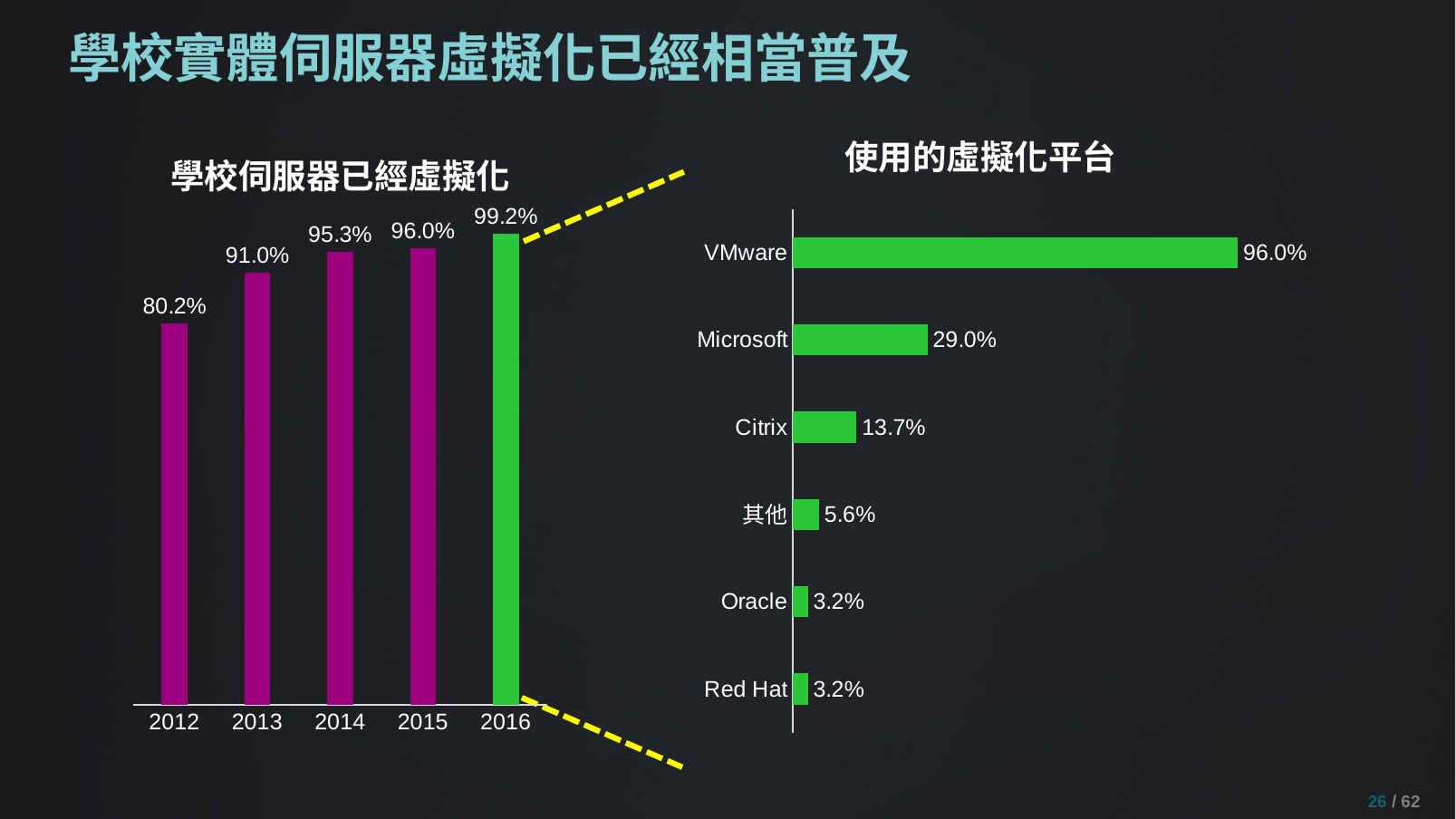
In the left chart (學校伺服器已經虛擬化), what is the value for 2016? 99.2% In the left chart (學校伺服器已經虛擬化), what is the value for 2012? 80.2% In the left chart (學校伺服器已經虛擬化), do the values rise or fall from 2012 to 2016? rise In the left chart (學校伺服器已經虛擬化), which year has the lowest value? 2012 In the right chart (使用的虛擬化平台), what is the difference between the VMware and Microsoft values? 67.0% In the left chart (學校伺服器已經虛擬化), what is the difference between the 2016 and 2012 values? 19.0% In the right chart (使用的虛擬化平台), how many platforms are listed? 6 In the right chart (使用的虛擬化平台), what is the value for Citrix? 13.7% In the left chart (學校伺服器已經虛擬化), how many years are shown? 5 What kind of chart is the right chart (使用的虛擬化平台)? bar chart In the right chart (使用的虛擬化平台), what is the value for Microsoft? 29.0% In the right chart (使用的虛擬化平台), which platform has the highest value? VMware